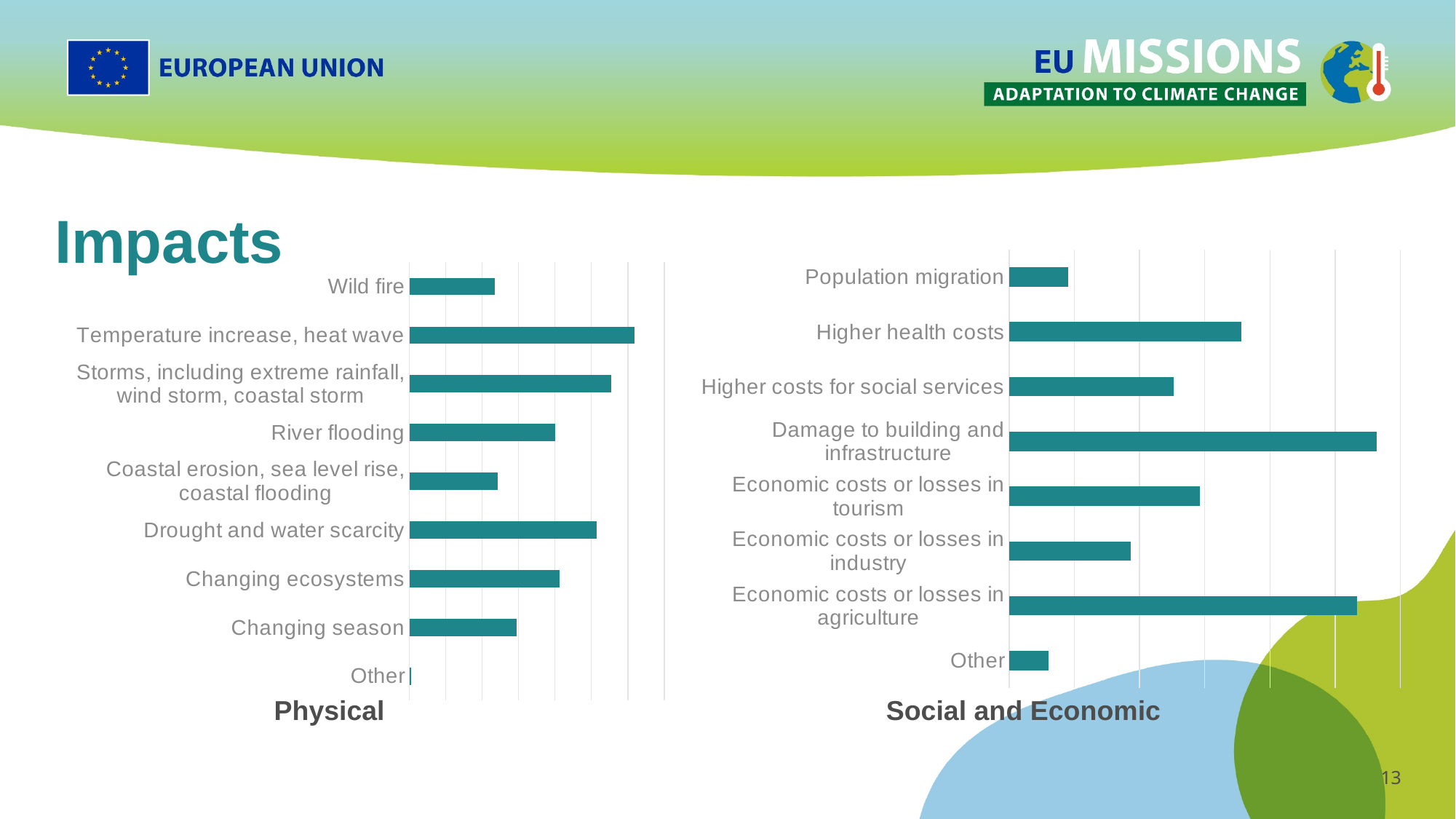
In the Social and Economic chart, which is larger: Higher health costs or Population migration? Higher health costs In the Physical chart, which category has the lowest value? Other In the Physical chart, which is larger: Drought and water scarcity or Changing season? Drought and water scarcity In the Social and Economic chart, which is larger: Economic costs or losses in tourism or Economic costs or losses in industry? Economic costs or losses in tourism How many categories are shown in the Social and Economic chart? 8 In the Physical chart, which category has the highest value? Temperature increase, heat wave In the Social and Economic chart, which category has the lowest value? Other What is the title of the slide containing the two charts? Impacts How many categories are shown in the Physical chart? 9 What kind of chart is the Physical chart? bar chart